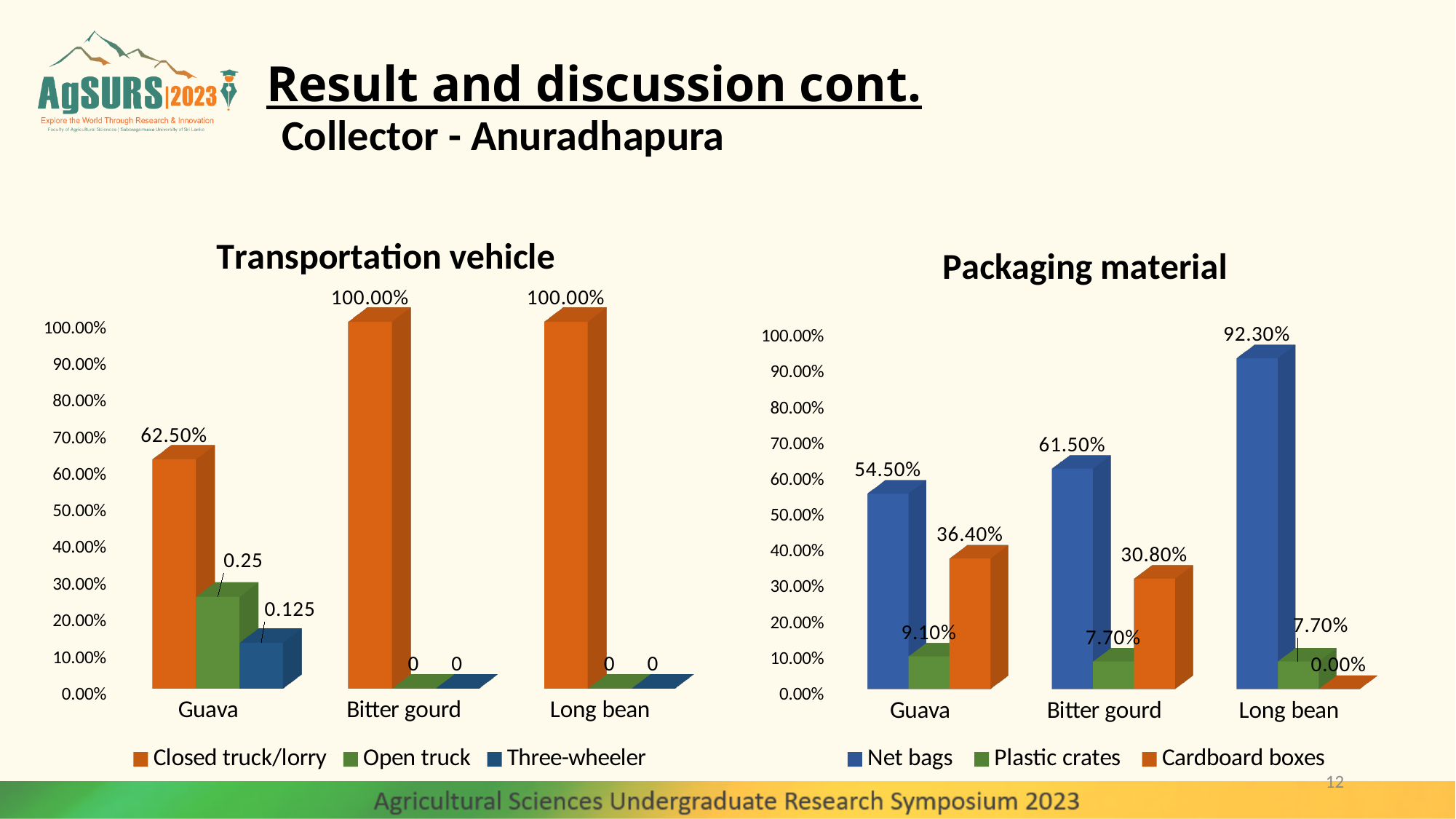
In the Packaging material chart, what is the value for Cardboard boxes for Bitter gourd? 30.80% What kind of chart is the Packaging material chart? Bar chart In the Transportation vehicle chart, what is the value for Closed truck/lorry for Long bean? 100.00% In the Transportation vehicle chart, which category has the lowest Closed truck/lorry value? Guava In the Transportation vehicle chart, how many series does the legend list? 3 In the Packaging material chart, which is larger for Guava: Net bags or Cardboard boxes? Net bags In the Transportation vehicle chart, what is the value for Closed truck/lorry for Guava? 62.50% In the Packaging material chart, which category has the highest Net bags value? Long bean In the Transportation vehicle chart, what is the value for Open truck for Guava? 0.25 In the Packaging material chart, what is the difference between the Net bags values for Bitter gourd and Guava? 7.00% In the Packaging material chart, how many categories are shown on the x axis? 3 In the Packaging material chart, what is the value for Net bags for Long bean? 92.30%